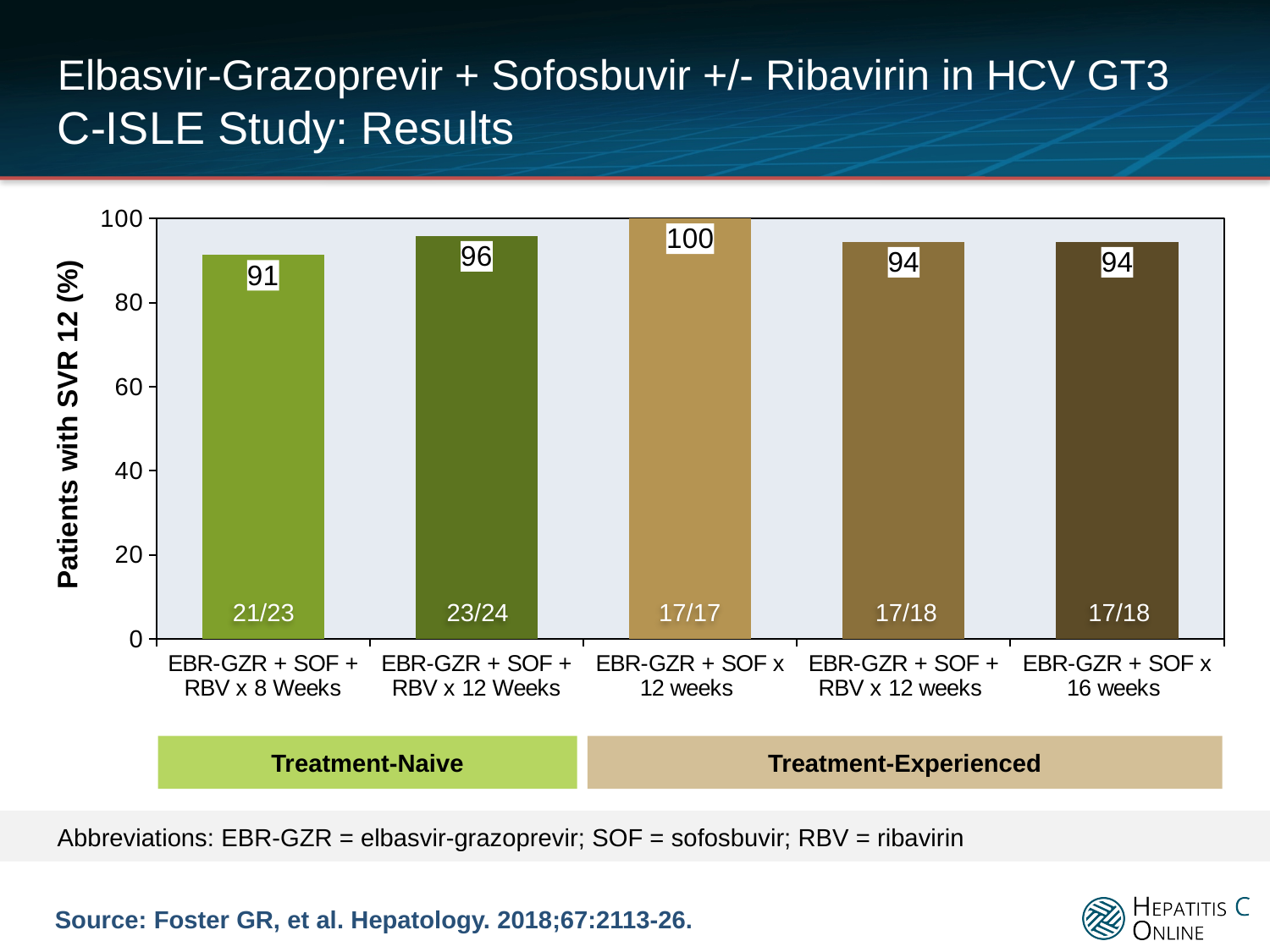
What is the SVR 12 rate for the EBR-GZR + SOF x 16 weeks arm? 94 What is the SVR 12 rate for the EBR-GZR + SOF + RBV x 8 Weeks arm? 91 What is the label of the y-axis? Patients with SVR 12 (%) Which treatment arm has the lowest SVR 12 rate? EBR-GZR + SOF + RBV x 8 Weeks Which has a higher SVR 12 rate: EBR-GZR + SOF + RBV x 12 Weeks or EBR-GZR + SOF + RBV x 8 Weeks? EBR-GZR + SOF + RBV x 12 Weeks What is the SVR 12 rate for the EBR-GZR + SOF x 12 weeks arm? 100 What kind of chart is shown on the slide? Bar chart How many treatment arms are grouped under Treatment-Experienced? 3 What is the difference in SVR 12 rate between the EBR-GZR + SOF x 12 weeks arm and the EBR-GZR + SOF + RBV x 8 Weeks arm? 9 How many patients achieved SVR 12 out of the total in the EBR-GZR + SOF + RBV x 12 Weeks arm? 23/24 How many treatment arms are shown in the chart? 5 Which treatment arm has the highest SVR 12 rate? EBR-GZR + SOF x 12 weeks